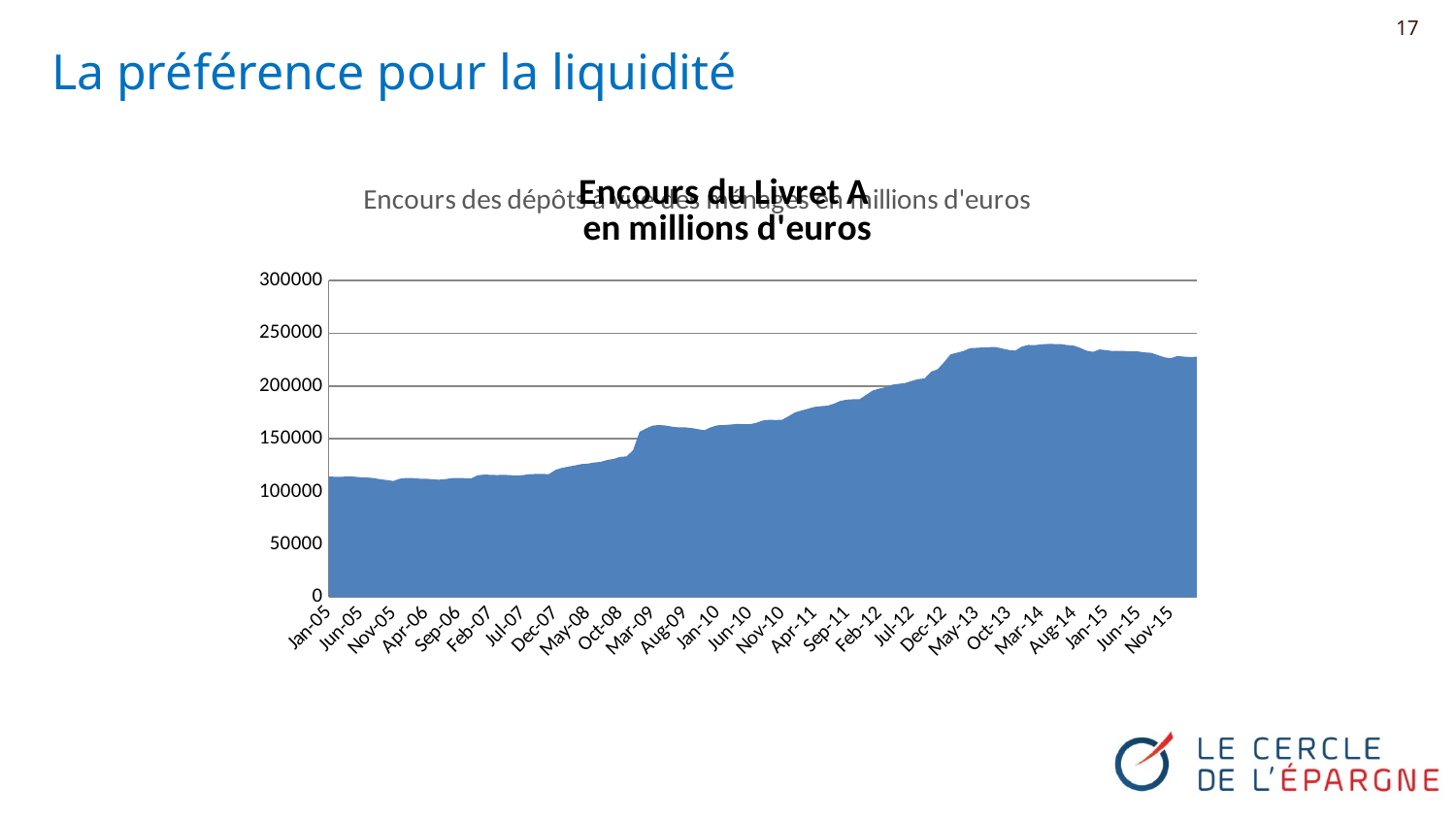
Is the value for Jan-05 greater or less than 150000? less What is the highest value shown on the vertical axis? 300000 Is the value for Jan-05 greater or less than 100000? greater Is the value for Nov-15 greater or less than 200000? greater What kind of chart is shown on the slide? area chart Overall, do the values rise or fall from Jan-05 to Nov-15? rise Which is larger, the value for Jul-12 or the value for Feb-07? Jul-12 Which is larger, the value for Jan-05 or the value for Nov-15? Nov-15